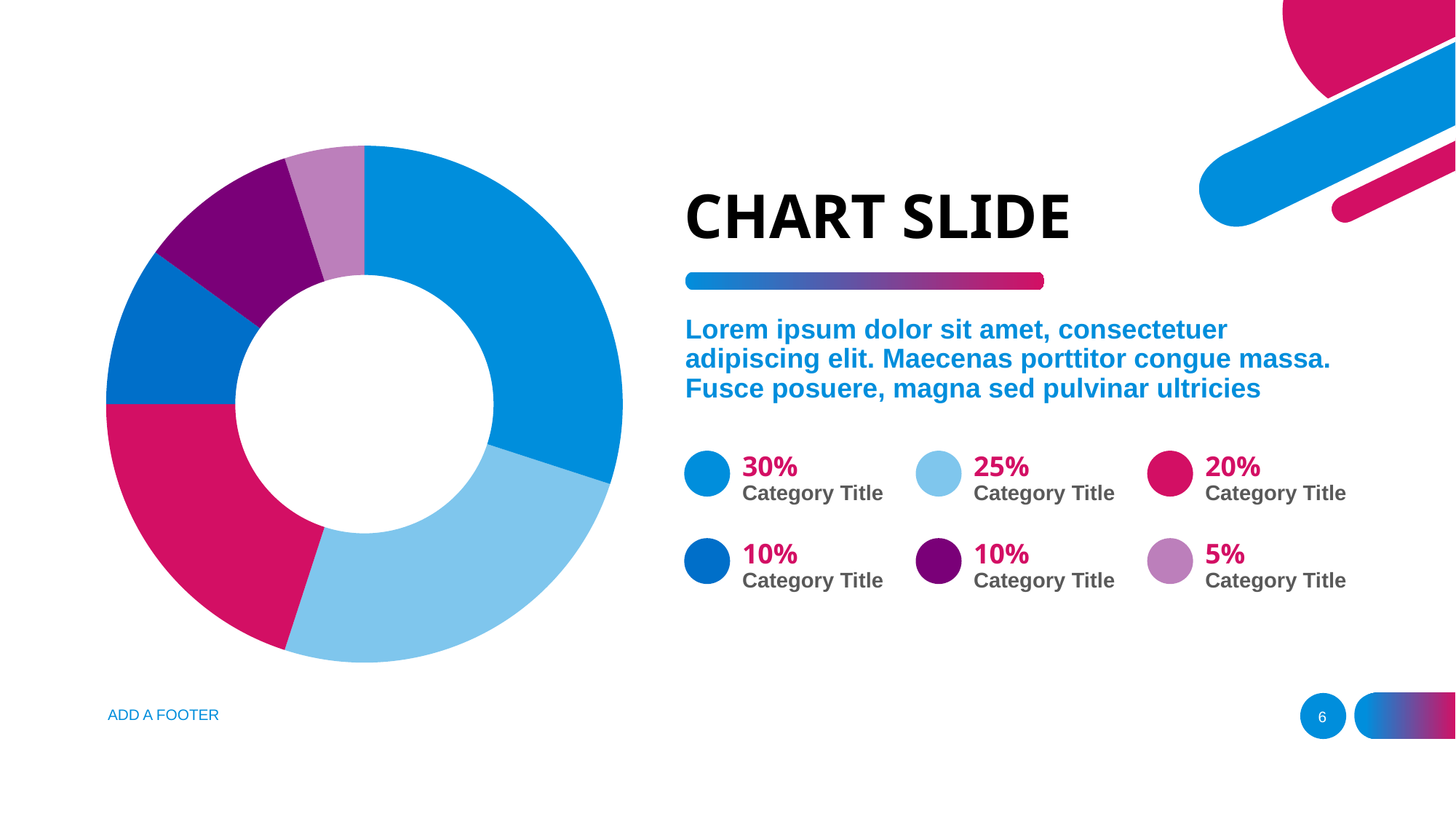
How many slices in the chart are labelled 10%? 2 What percentage does the magenta (pink-red) slice represent? 20% Which slice is larger, the light blue one or the magenta one? The light blue one (25%) What is the difference between the largest slice (30%) and the smallest slice (5%)? 25 percentage points What is the combined share of the two 10% slices and the 5% slice? 25% What is the smallest share shown in the doughnut chart? 5% What is the title of the slide containing the chart? CHART SLIDE What is the largest share shown in the doughnut chart? 30% What percentage does the light blue slice represent? 25% How many slices does the doughnut chart have? 6 What kind of chart is shown on the slide? Doughnut (pie) chart What percentage does the light purple (mauve) slice represent? 5%